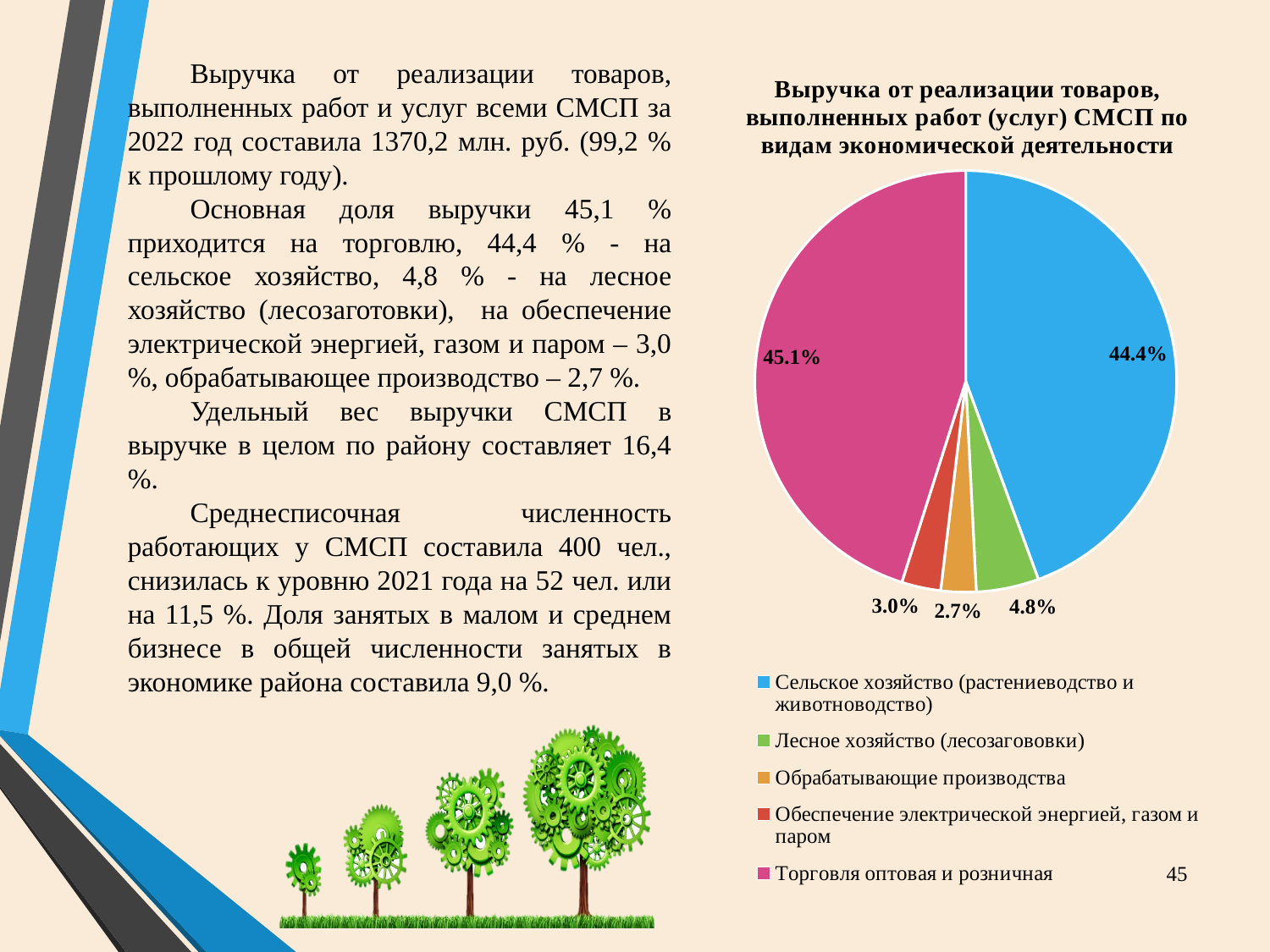
Which is larger: the slice for Лесное хозяйство or the slice for Обеспечение электрической энергией, газом и паром? Лесное хозяйство What colour is the slice for Сельское хозяйство (растениеводство и животноводство)? blue What share of the pie does Обеспечение электрической энергией, газом и паром have? 3.0% What share of the pie does Торговля оптовая и розничная have? 45.1% Which category has the smallest slice of the pie? Обрабатывающие производства How many categories does the pie chart have? 5 What kind of chart is shown on the slide? pie chart Which category has the largest slice of the pie? Торговля оптовая и розничная What is the difference in percentage points between Торговля оптовая и розничная and Сельское хозяйство? 0.7 What share of the pie does Сельское хозяйство (растениеводство и животноводство) have? 44.4% What share of the pie does Лесное хозяйство (лесозаговoвки) have? 4.8% What share of the pie does Обрабатывающие производства have? 2.7%